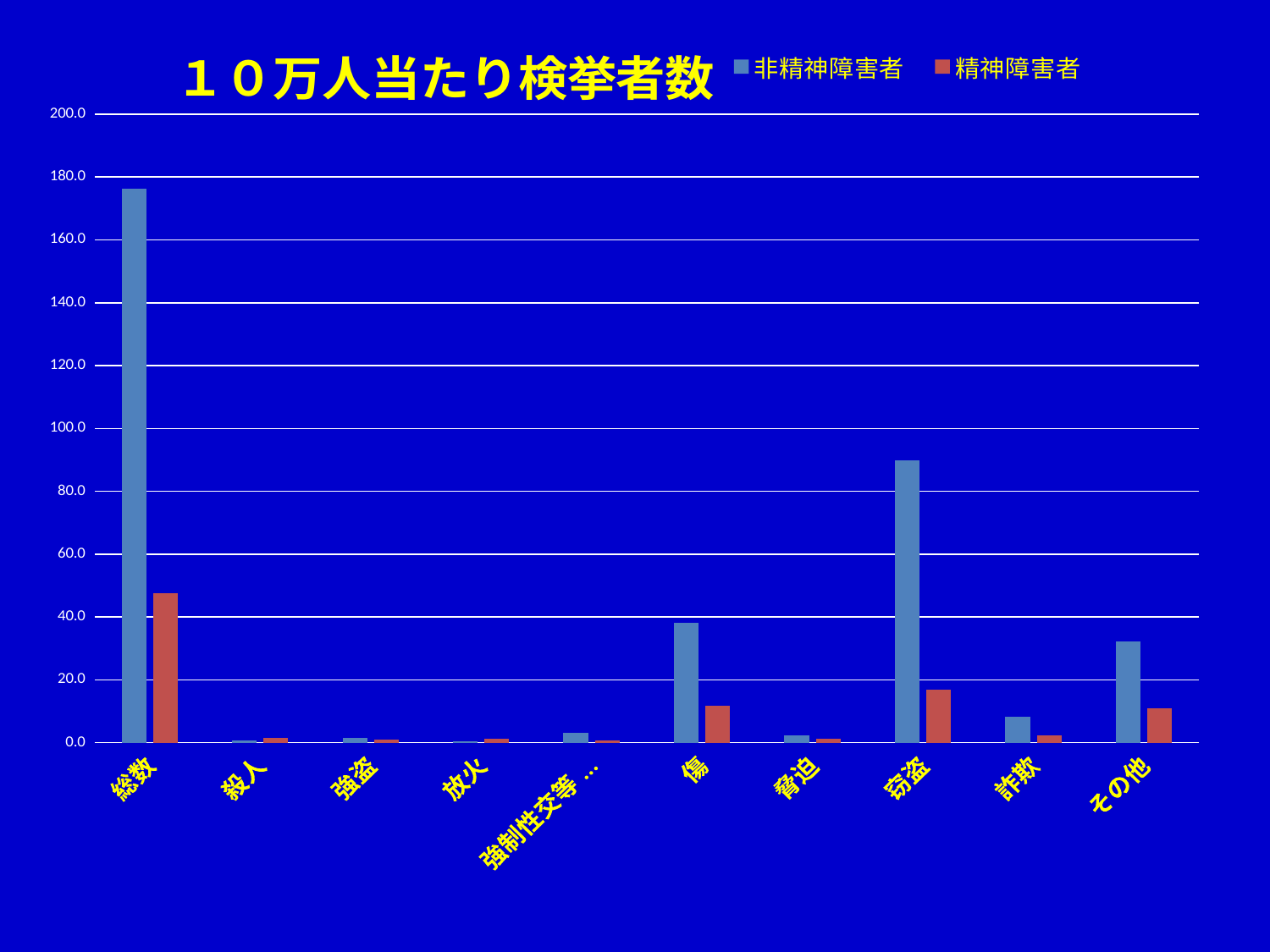
Which category has the highest value for 非精神障害者? 総数 Is the value for 窃盗 in the 非精神障害者 series greater or less than 100? less Is the value for 窃盗 in the 精神障害者 series greater or less than 20? less For the 精神障害者 series, which is larger: 総数 or 窃盗? 総数 Which category has the highest value for 精神障害者? 総数 How many series does the legend list? 2 What kind of chart is shown on the slide? bar chart Is the value for 総数 in the 精神障害者 series greater or less than 40? greater What is the title of the chart? １０万人当たり検挙者数 How many categories are shown on the x axis? 10 For the 非精神障害者 series, which is larger: 窃盗 or その他? 窃盗